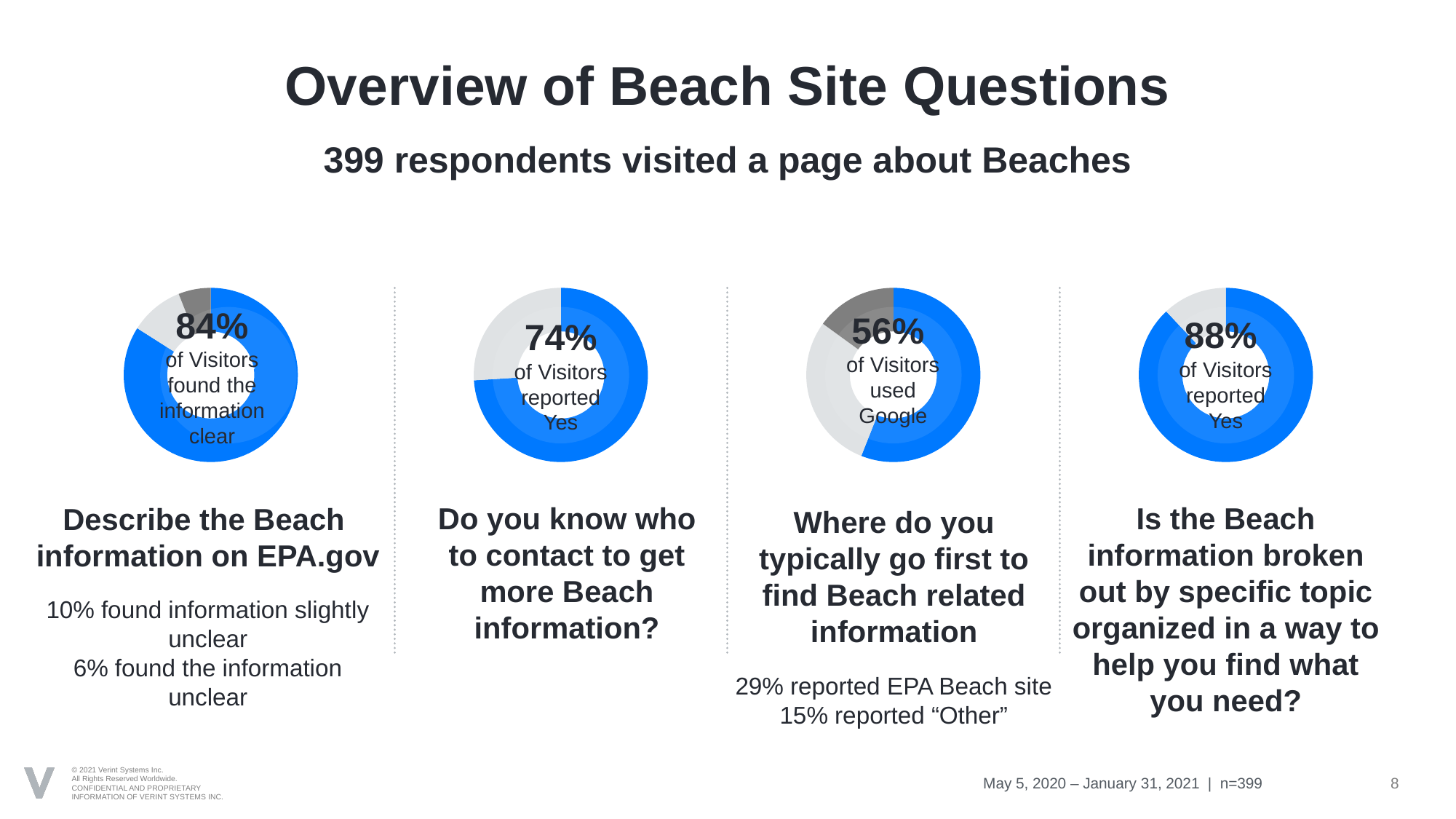
Which of the four donut charts shows the lowest highlighted percentage? The third chart from the left (56% used Google) In the rightmost donut chart (Is the Beach information broken out by specific topic...), what percentage of visitors reported Yes? 88% In the leftmost donut chart, what percentage of visitors found the information slightly unclear? 10% Which of the four donut charts shows the highest highlighted percentage? The rightmost chart (88% reported Yes) What kind of chart is used for each of the four questions on the slide? Donut (pie) chart In the leftmost donut chart (Describe the Beach information on EPA.gov), what percentage of visitors found the information clear? 84% What is the difference between the percentage of visitors who used Google and the percentage who reported EPA Beach site in the third donut chart? 27% In the third donut chart from the left, what percentage of visitors reported EPA Beach site? 29% How many donut charts are shown on the slide? 4 In the third donut chart from the left (Where do you typically go first to find Beach related information), what percentage of visitors used Google? 56% In the leftmost donut chart, is the share of visitors who found the information clear larger than the share who found it unclear? Yes, 84% vs 6% In the second donut chart from the left (Do you know who to contact to get more Beach information?), what percentage of visitors reported Yes? 74%